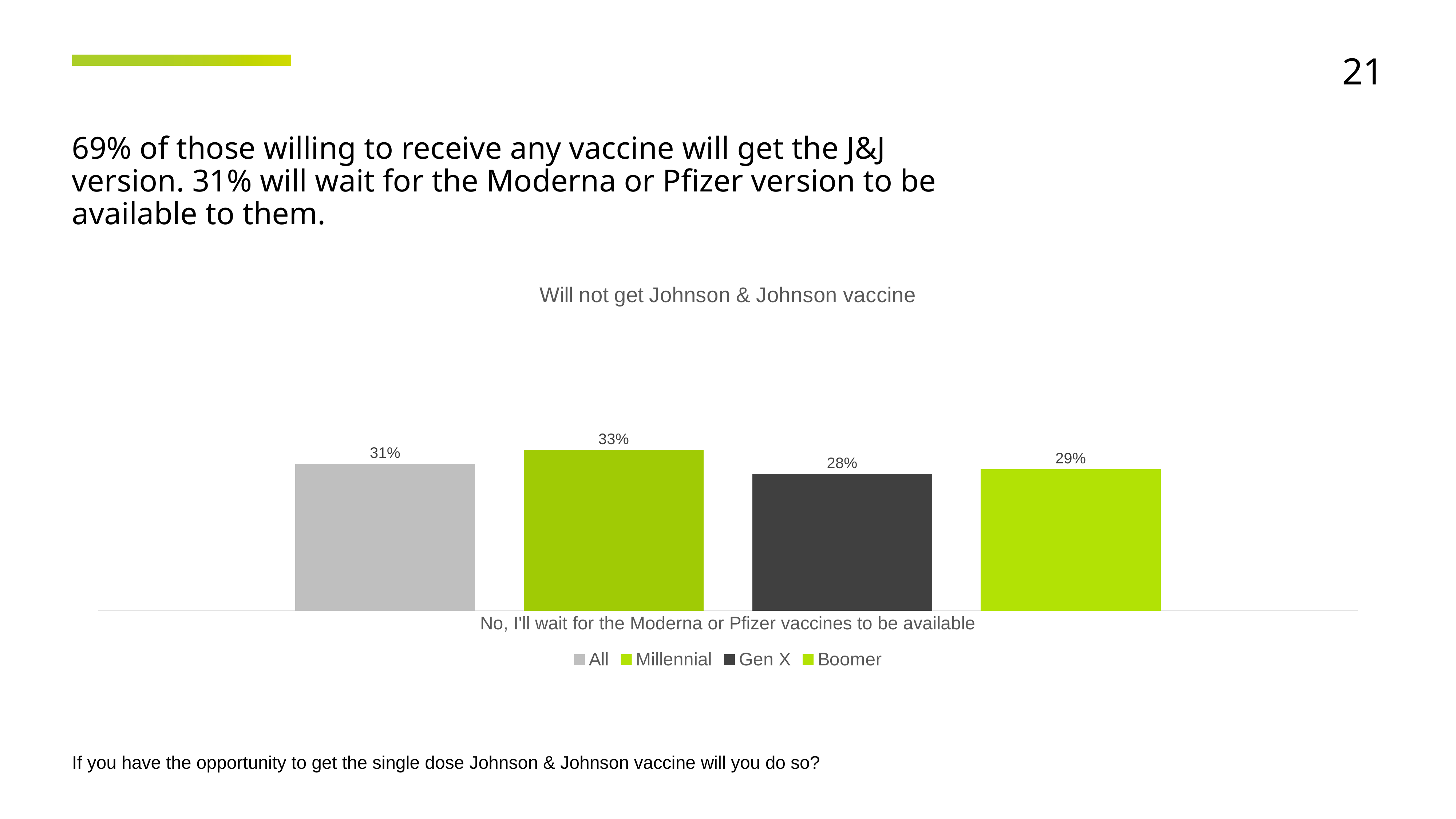
What kind of chart is shown on the slide? Bar chart Which series has the lowest value in the chart? Gen X What is the value for Boomer in the chart? 29% What is the value for Gen X in the chart? 28% What is the difference between the Millennial and Gen X values? 5% What is the difference between the All and Boomer values? 2% How many series does the legend list? 4 Which is larger, the value for Millennial or the value for Boomer? Millennial What is the value for Millennial in the chart? 33% What is the value for All in the chart? 31% Which series has the highest value in the chart? Millennial What is the title of the chart? Will not get Johnson & Johnson vaccine